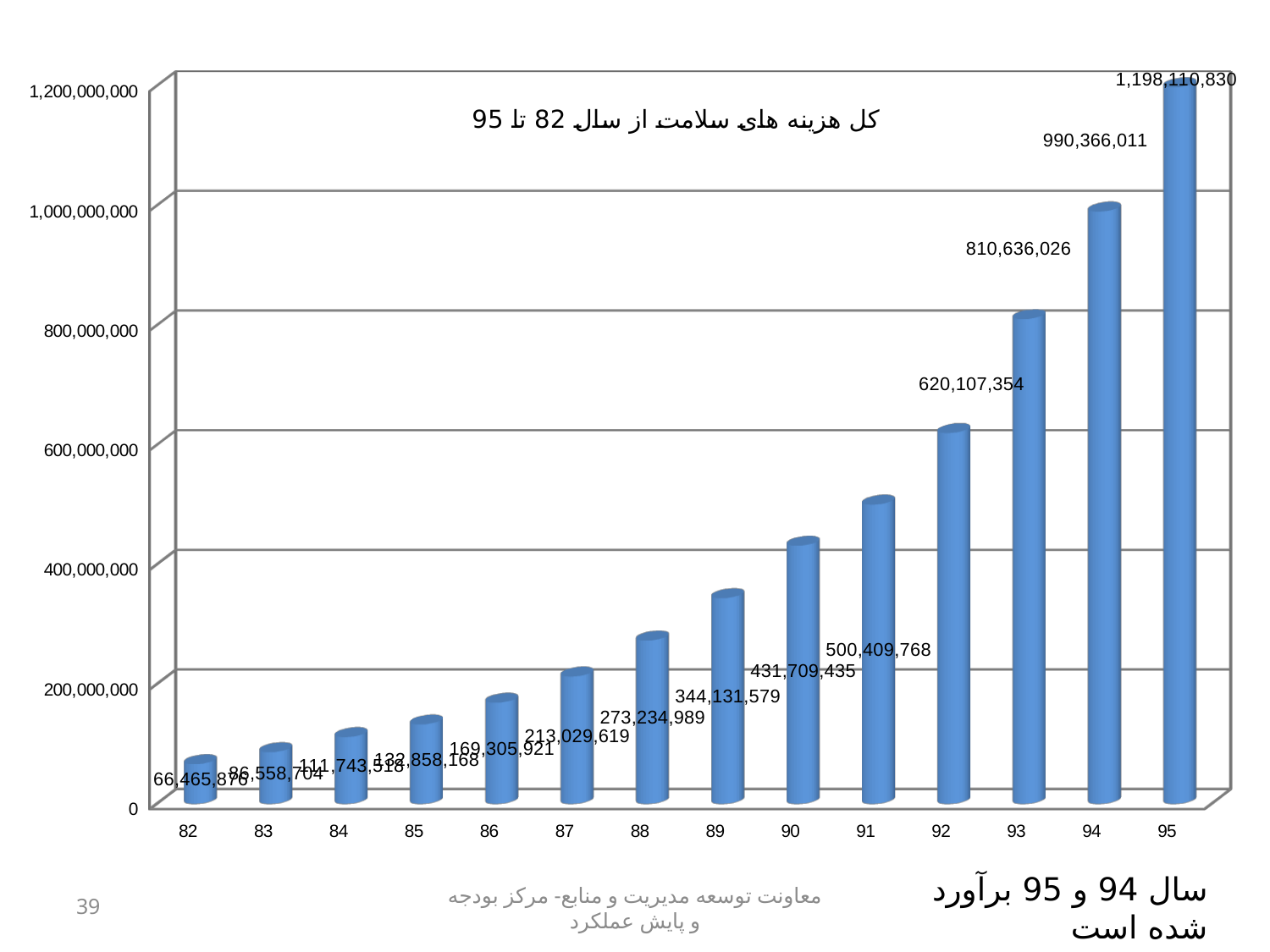
What is the value for year 90? 431,709,435 What is the value for year 95? 1,198,110,830 Which is larger, the value for year 89 or year 90? 90 What is the value for year 93? 810,636,026 What is the difference between the values for year 93 and year 92? 190,528,672 What is the difference between the values for year 95 and year 94? 207,744,819 What is the value for year 88? 273,234,989 Which year has the highest value? 95 Is the value for year 86 greater or less than 200,000,000? less Do the values rise or fall from year 82 to year 95? rise Which year has the lowest value? 82 How many years are shown on the x axis? 14